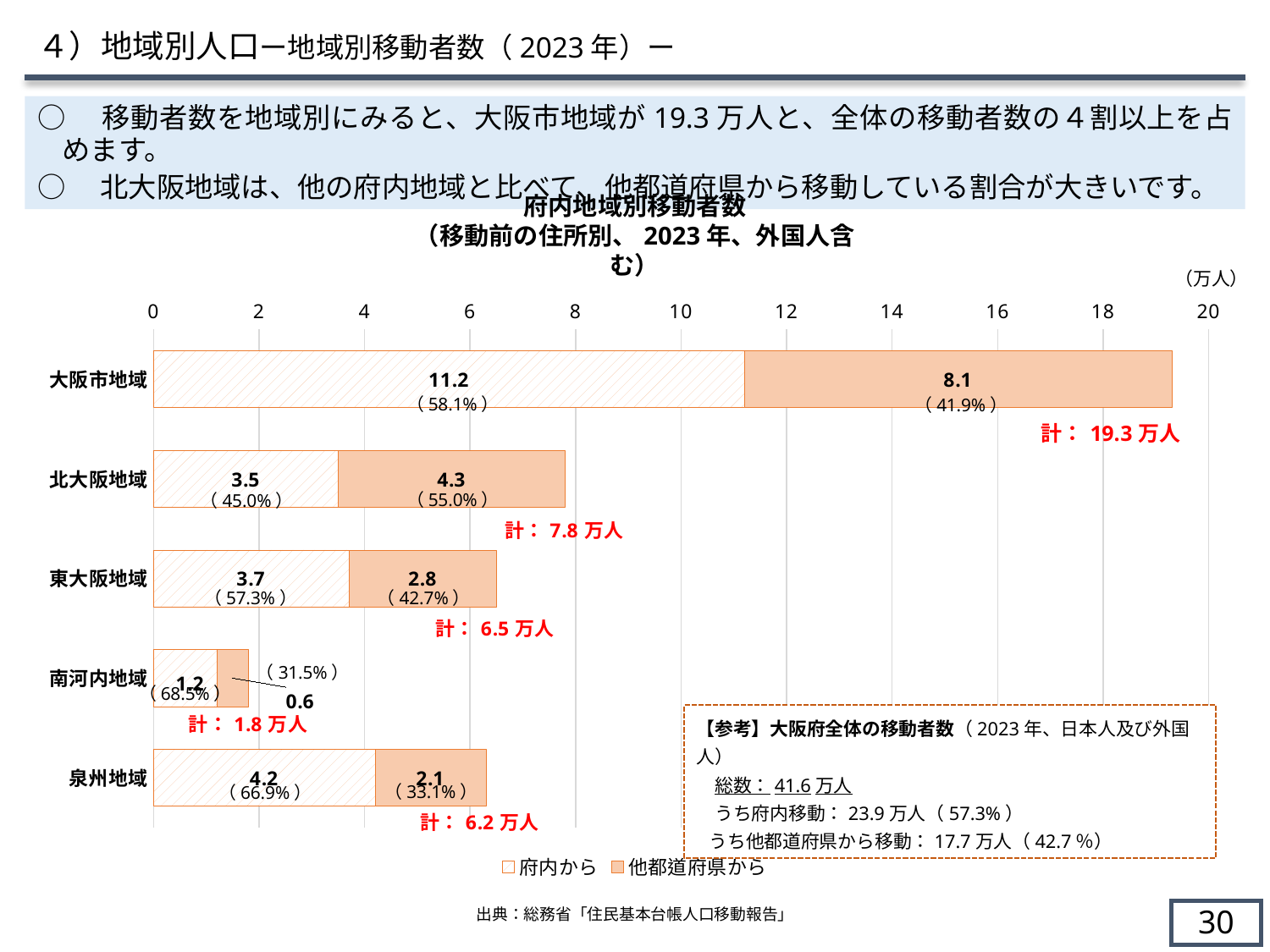
For 北大阪地域, which is larger: 府内から or 他都道府県から? 他都道府県から Which region has the highest total number of movers? 大阪市地域 How many series does the legend list? 2 Which region has the lowest total number of movers? 南河内地域 What is the total (計) for 泉州地域? 6.2 万人 What percentage share does 他都道府県から represent for 東大阪地域? 42.7% What is the value of 府内から for 大阪市地域? 11.2 What unit is shown at the top right of the chart axis? 万人 What is the difference between 府内から and 他都道府県から for 大阪市地域? 3.1 How many regions (categories) are plotted in the chart? 5 What type of chart is shown on the slide? Stacked bar chart What is the value of 他都道府県から for 北大阪地域? 4.3